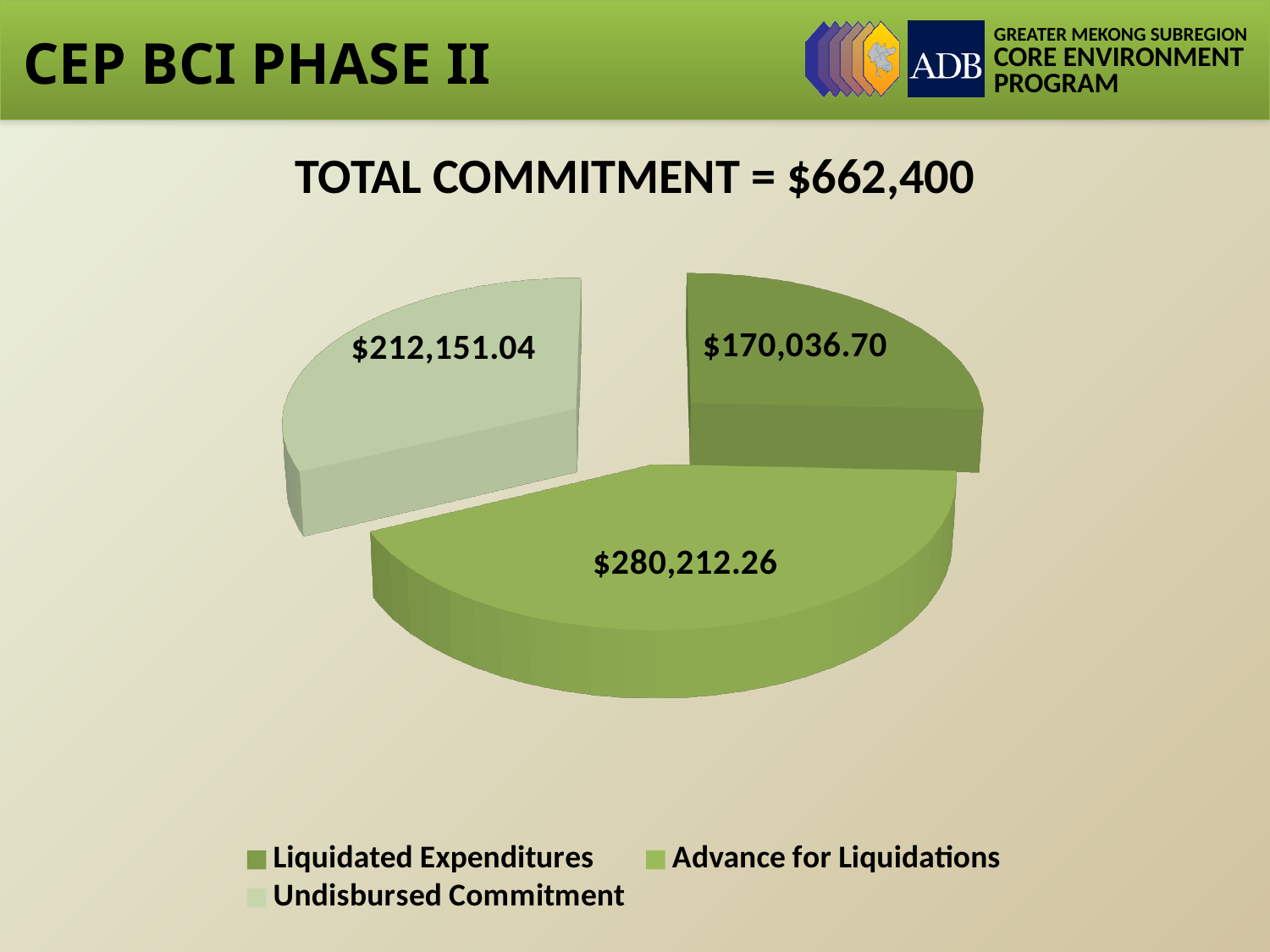
What is the value of the Liquidated Expenditures slice? $170,036.70 Which category has the largest slice of the pie? Advance for Liquidations What is the difference between the Advance for Liquidations and Liquidated Expenditures values? $110,175.56 Which is larger, Undisbursed Commitment or Liquidated Expenditures? Undisbursed Commitment What is the difference between the Undisbursed Commitment and Liquidated Expenditures values? $42,114.34 What is the value of the Advance for Liquidations slice? $280,212.26 Which category has the smallest slice of the pie? Liquidated Expenditures How many slices does the pie chart have? 3 What total commitment is stated in the chart title? $662,400 What is the value of the Undisbursed Commitment slice? $212,151.04 What is the total of the three slices in the pie chart? $662,400.00 What kind of chart is shown on the slide? Pie chart